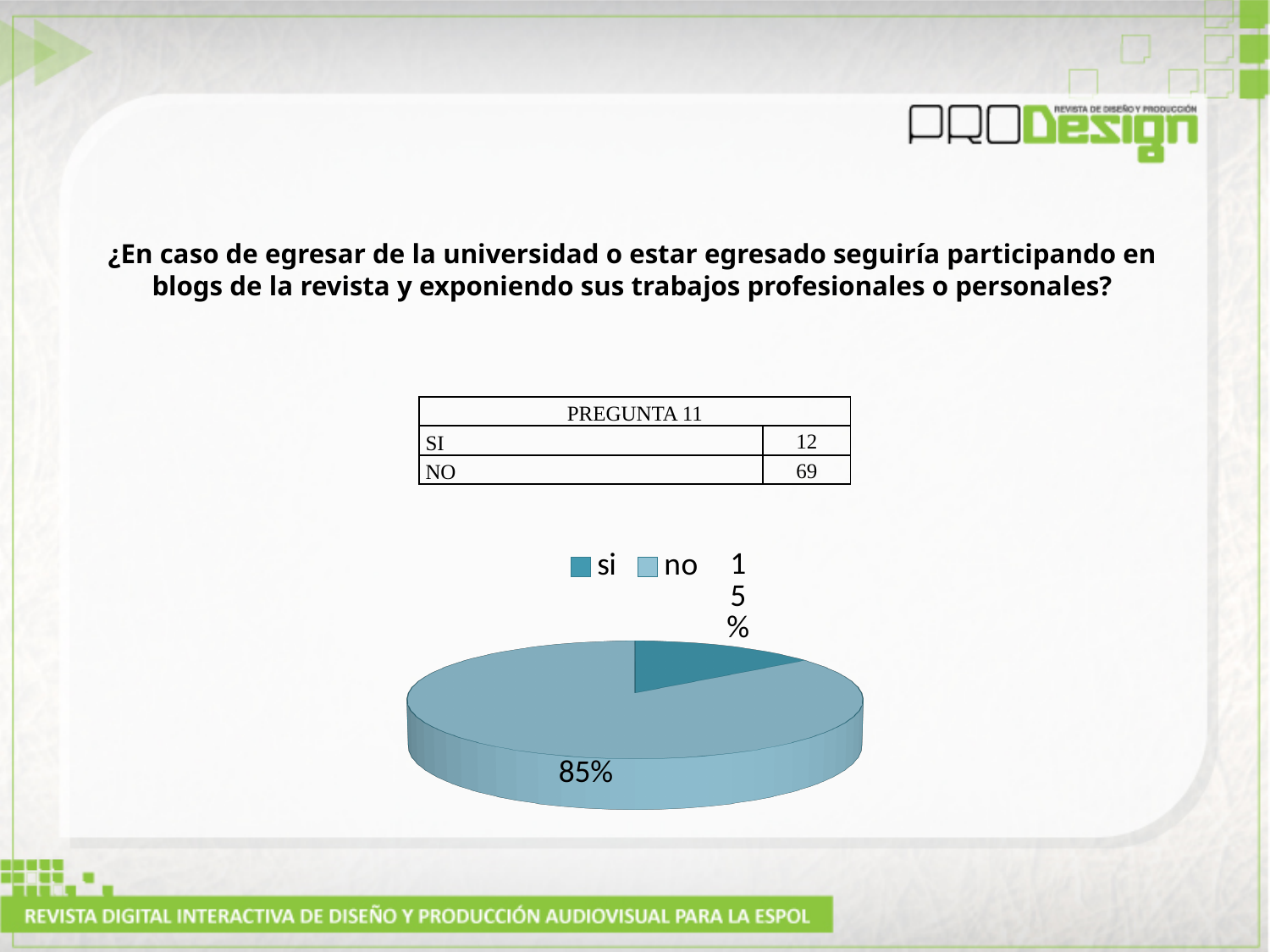
Which slice of the pie is the largest? no What are the two legend entries of the pie chart? si, no What share of the pie does the 'no' slice represent? 85% Is the share for 'no' greater or less than 50%? greater How many entries does the legend list? 2 What kind of chart is shown on the slide? pie chart What is the difference in percentage points between the 'no' slice and the 'si' slice? 70% Which legend entry is shown in the darker teal colour? si How many slices does the pie chart have? 2 Which slice of the pie is the smallest? si Which is larger, the 'si' slice or the 'no' slice? no What share of the pie does the 'si' slice represent? 15%